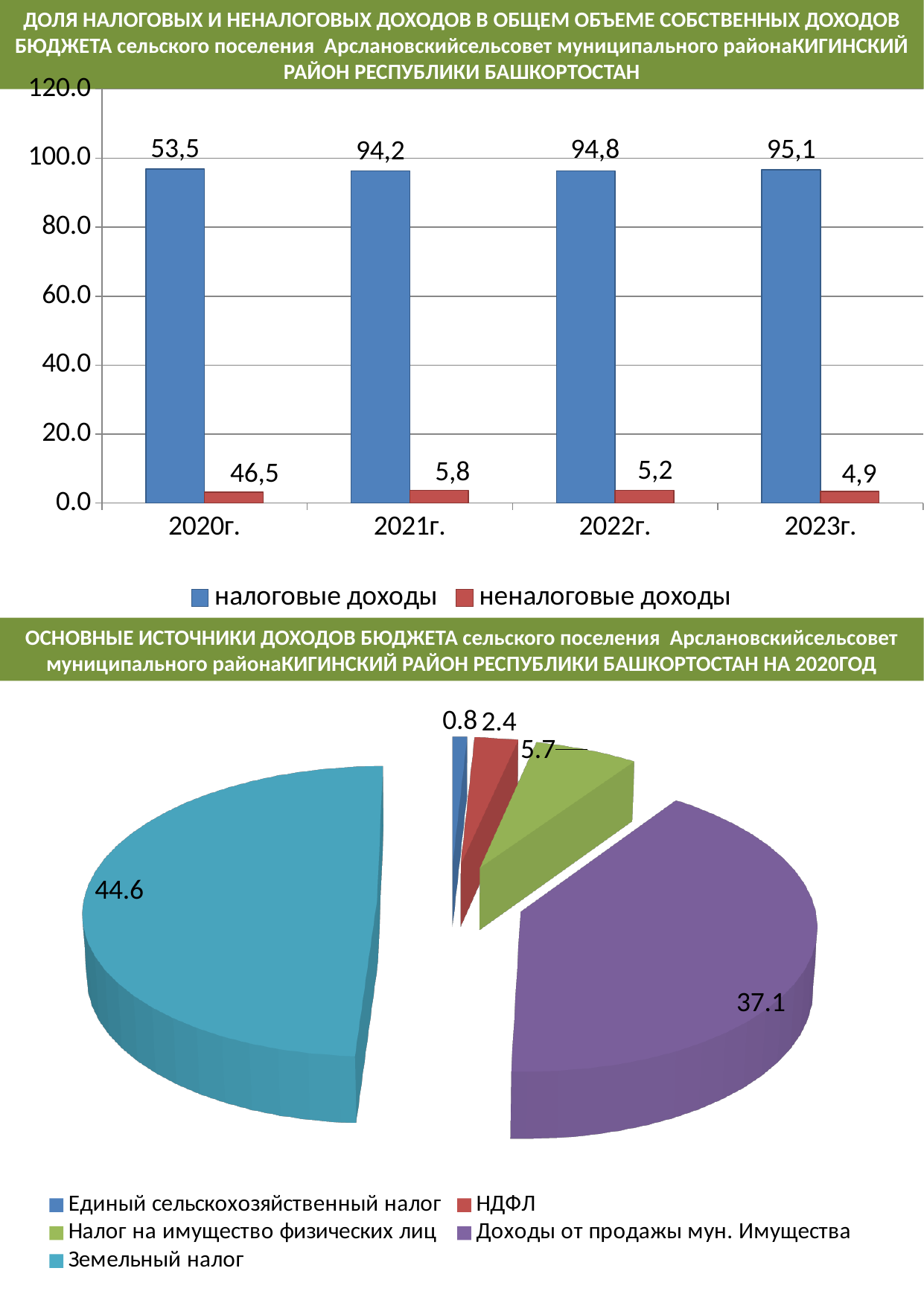
What kind of chart is the top chart on the slide? bar chart In the top bar chart, what is the difference between налоговые доходы and неналоговые доходы for 2021г.? 88,4 In the top bar chart, what is the value of неналоговые доходы for 2020г.? 46,5 In the top bar chart, what is the value of неналоговые доходы for 2022г.? 5,2 In the top bar chart, which year has the highest value for неналоговые доходы? 2020г. What kind of chart is the bottom chart on the slide? pie chart In the top bar chart, what is the value of налоговые доходы for 2023г.? 95,1 In the bottom pie chart, what is the value for Доходы от продажи мун. Имущества? 37.1 In the top bar chart, do the values for неналоговые доходы rise or fall from 2020г. to 2023г.? fall In the bottom pie chart, which category has the largest slice? Земельный налог How many series does the legend of the top bar chart list? 2 In the top bar chart, which year has the lowest value for неналоговые доходы? 2023г.